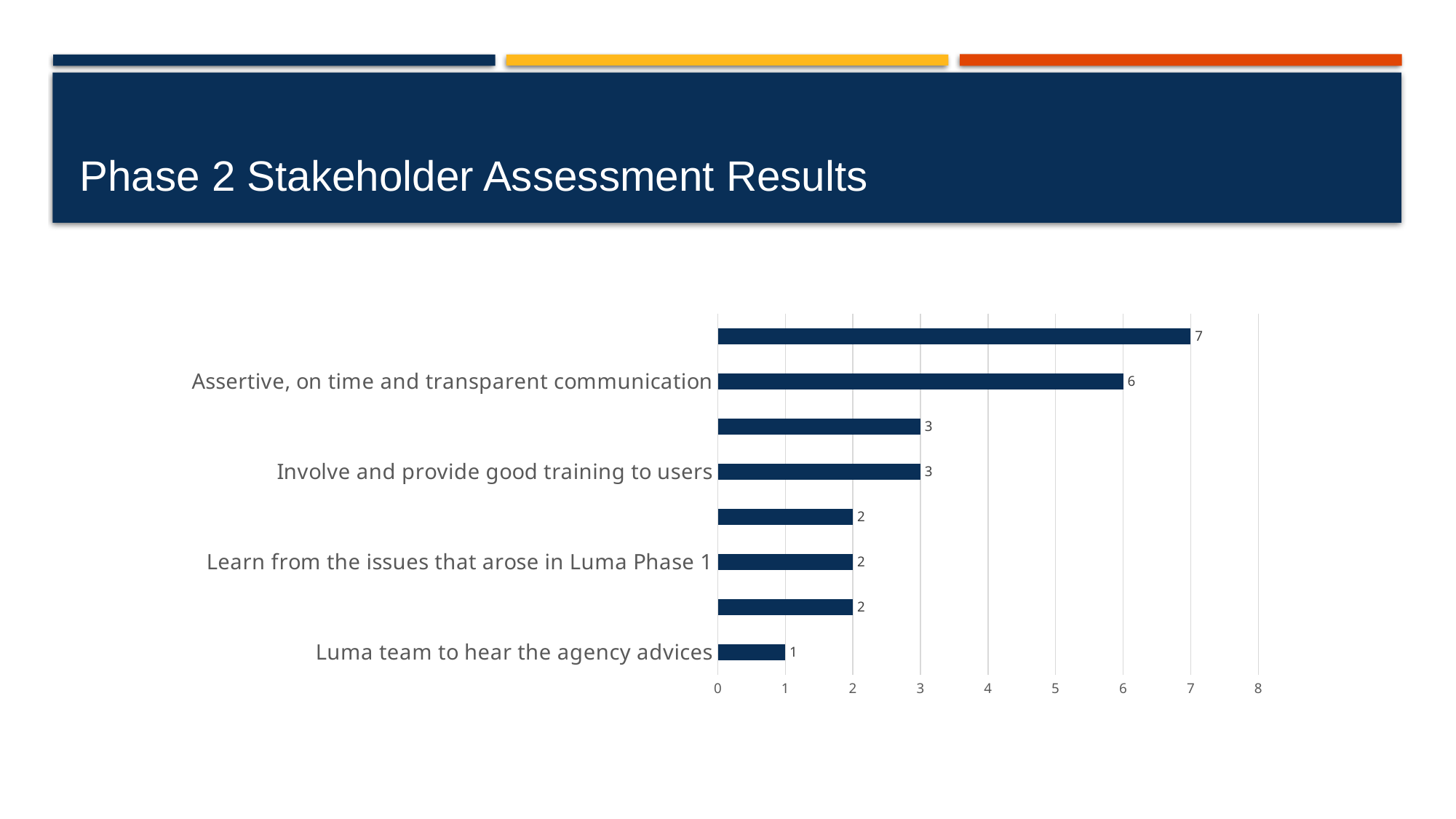
What is the difference between the values for "Assertive, on time and transparent communication" and "Involve and provide good training to users"? 3 What is the value for "Luma team to hear the agency advices"? 1 Which is larger: the value for "Assertive, on time and transparent communication" or the value for "Involve and provide good training to users"? Assertive, on time and transparent communication Which category has the lowest value in the chart? Luma team to hear the agency advices What is the value for "Involve and provide good training to users"? 3 What is the highest value shown on the horizontal axis of the chart? 8 What is the value for "Learn from the issues that arose in Luma Phase 1"? 2 Is the value for "Assertive, on time and transparent communication" greater or less than 5? greater What is the value for "Assertive, on time and transparent communication"? 6 How many bars are plotted in the chart? 8 What kind of chart is shown on the slide? bar chart What is the difference between the values for "Learn from the issues that arose in Luma Phase 1" and "Luma team to hear the agency advices"? 1